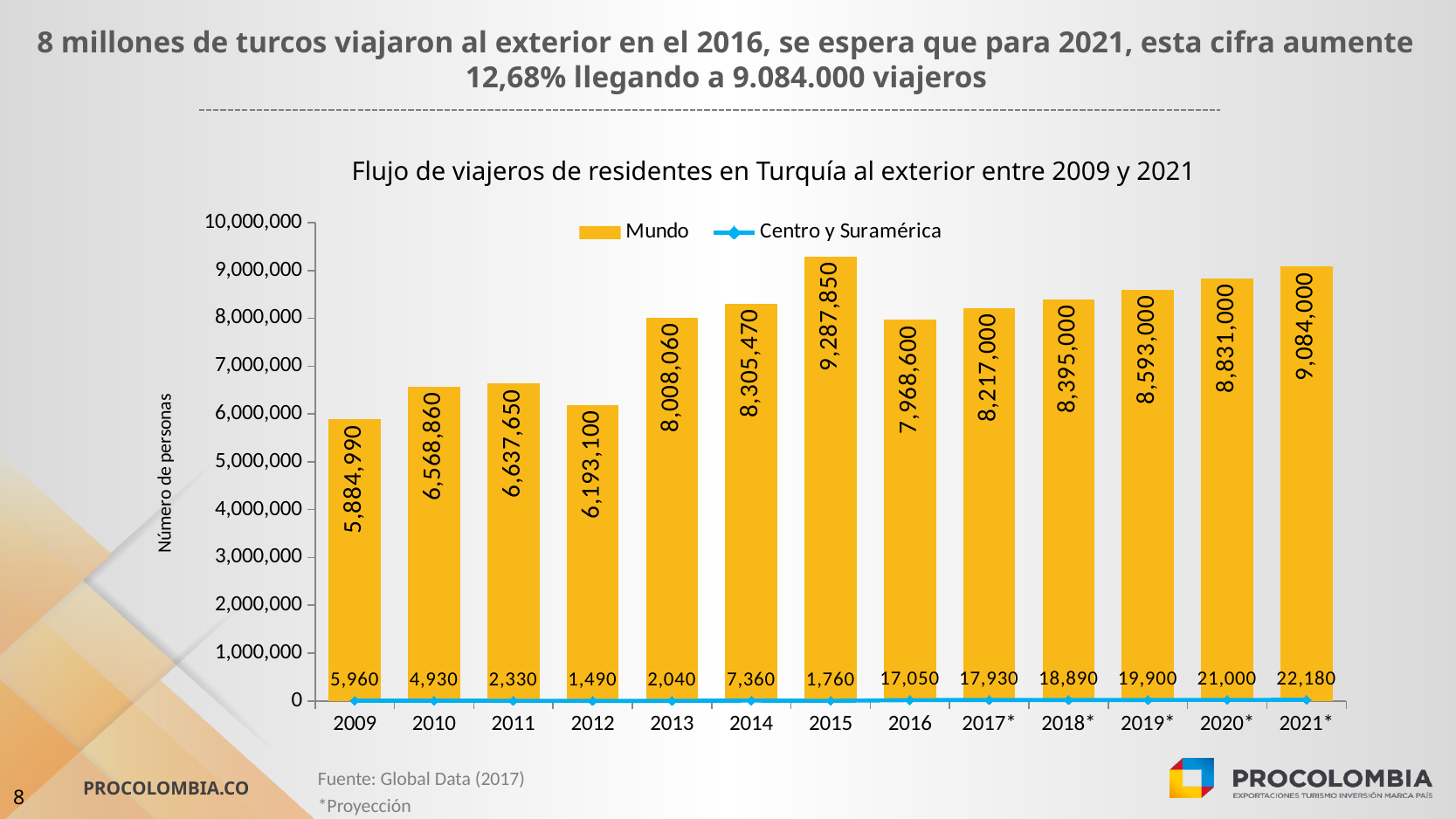
Which year has the lowest Centro y Suramérica value? 2012 What is the Mundo value for 2015? 9,287,850 What is the Centro y Suramérica value for 2016? 17,050 What is the difference between the Mundo values for 2021* and 2016? 1,115,400 How many years are shown on the x axis? 13 Which is larger, the Mundo value for 2011 or for 2012? 2011 What is the title of the chart? Flujo de viajeros de residentes en Turquía al exterior entre 2009 y 2021 Which year has the lowest Mundo value? 2009 Do the Centro y Suramérica values rise or fall from 2016 to 2021*? rise Is the Mundo value for 2013 greater or less than 7,000,000? greater How many series does the legend list? 2 Which year has the highest Mundo value? 2015